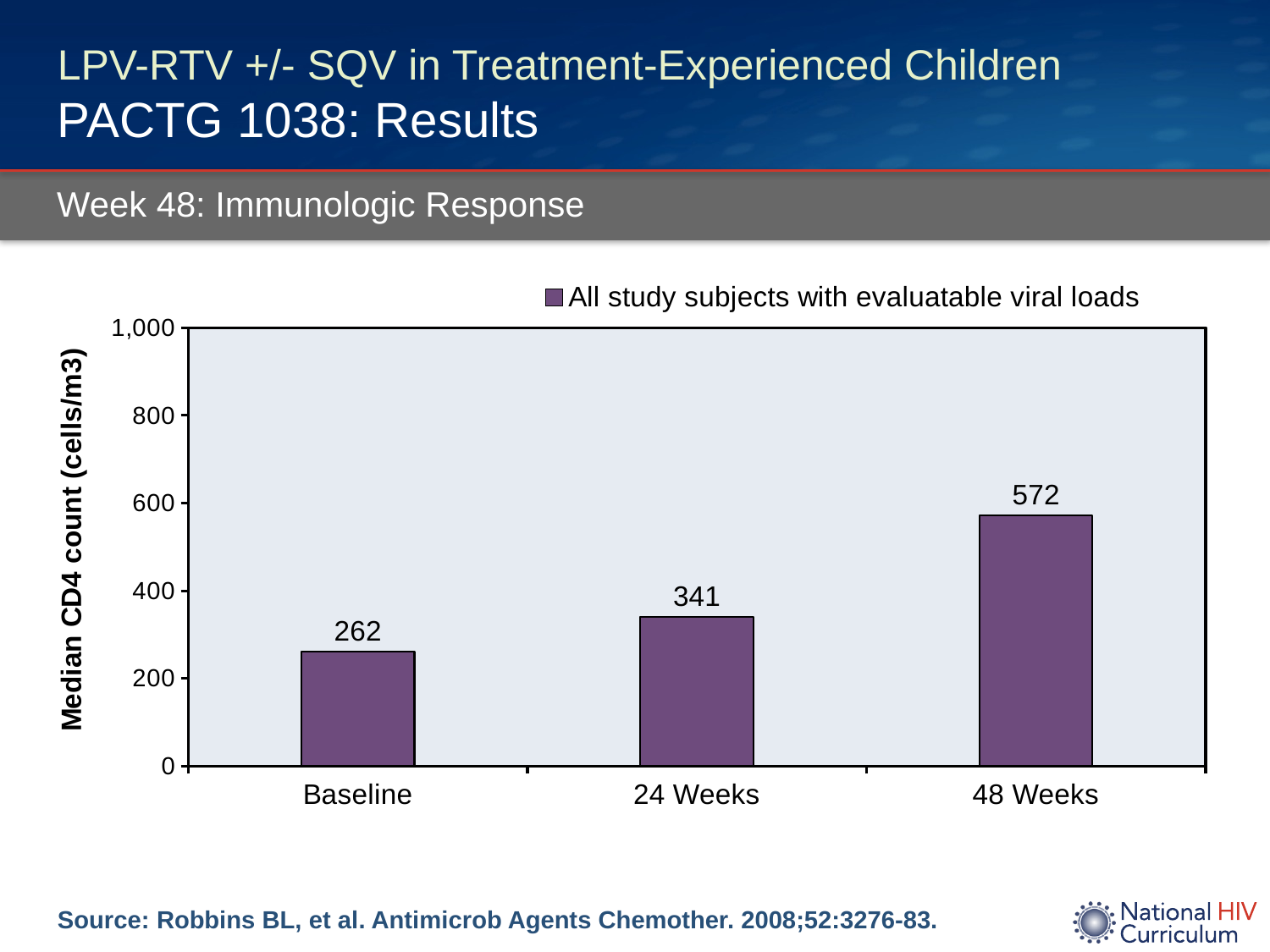
What is the difference in median CD4 count between 48 Weeks and Baseline? 310 Which time point has the highest median CD4 count? 48 Weeks Is the median CD4 count at 48 Weeks greater or less than 600? less What is the median CD4 count at Baseline? 262 What is the median CD4 count at 48 Weeks? 572 What kind of chart is shown on the slide? bar chart How many time points are shown on the x axis? 3 What is the difference in median CD4 count between 24 Weeks and Baseline? 79 Does the median CD4 count rise or fall from Baseline to 48 Weeks? rise Which time point has the lowest median CD4 count? Baseline Which is larger, the median CD4 count at 24 Weeks or at 48 Weeks? 48 Weeks What is the median CD4 count at 24 Weeks? 341